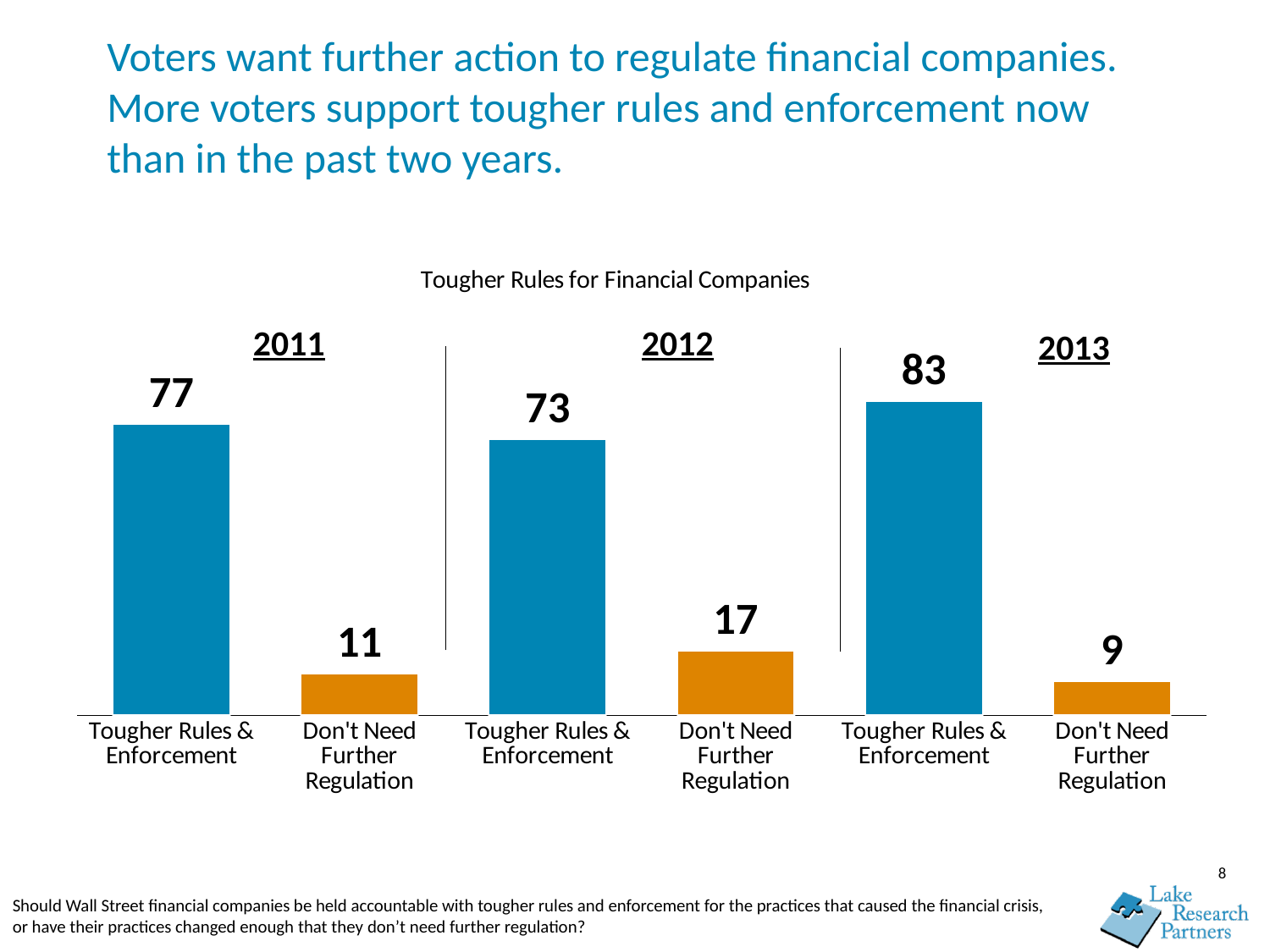
What kind of chart is shown on the slide? Bar chart What is the value for Tougher Rules & Enforcement in 2011? 77 In which year is the Tougher Rules & Enforcement bar highest? 2013 Which is larger: Don't Need Further Regulation in 2012 or in 2011? 2012 Which bar has the lowest value on the chart? Don't Need Further Regulation in 2013 What is the value for Don't Need Further Regulation in 2012? 17 How many bars are plotted on the chart? 6 What is the value for Don't Need Further Regulation in 2013? 9 What is the value for Tougher Rules & Enforcement in 2013? 83 What is the title of the chart? Tougher Rules for Financial Companies What is the difference between Tougher Rules & Enforcement and Don't Need Further Regulation in 2011? 66 How much higher is Tougher Rules & Enforcement in 2013 than in 2012? 10